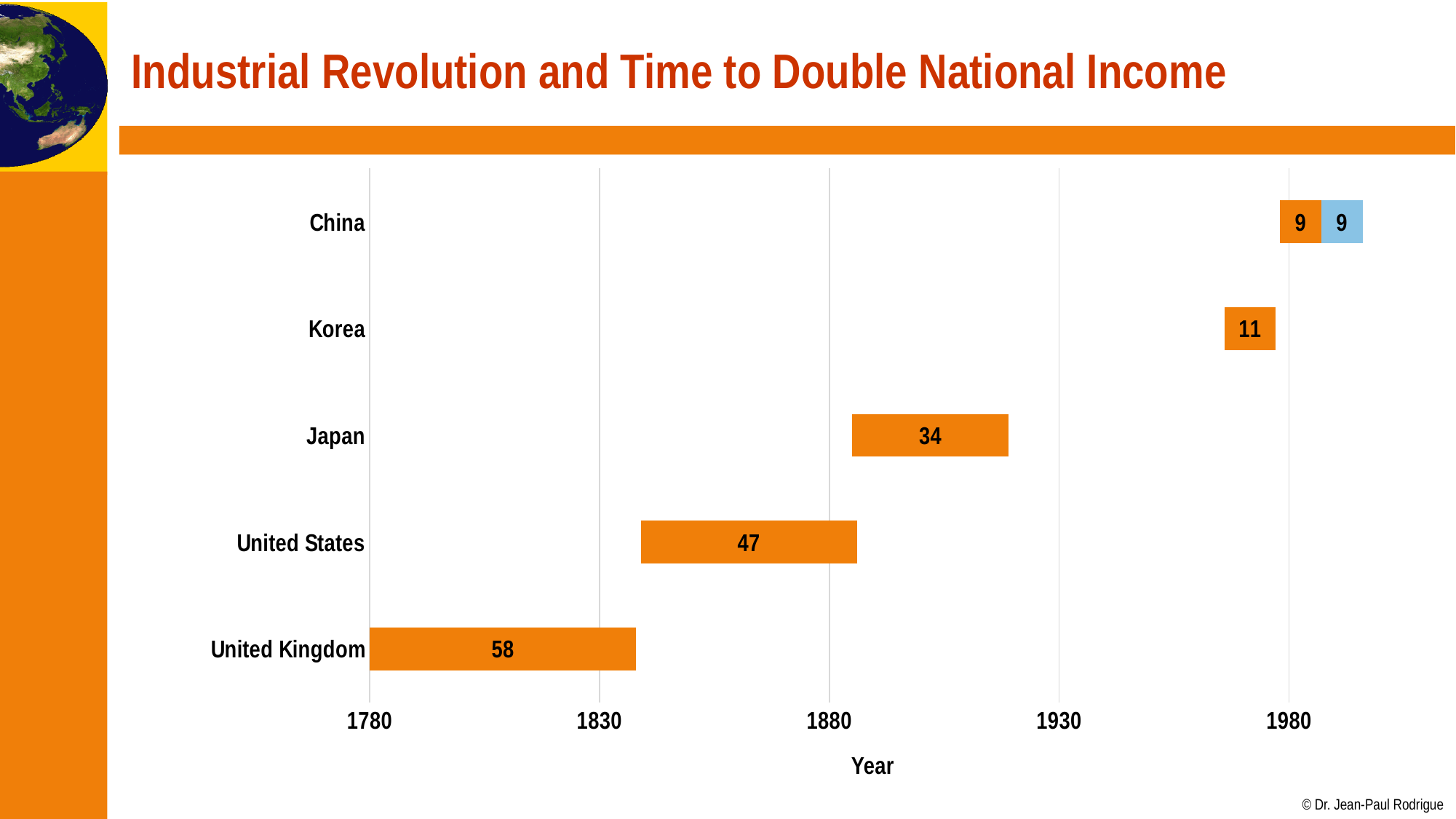
How many countries are shown on the chart? 5 Which country has the smallest labeled value? China Which is larger, the value for Japan or the value for Korea? Japan What kind of chart is shown on the slide? Bar chart What is the value labeled on the bar for Japan? 34 What is the value labeled on the bar for the United States? 47 What is the difference between the values for the United Kingdom and the United States? 11 Which country has the largest labeled value? United Kingdom What is the value labeled on the bar for Korea? 11 What is the value labeled on the bar for the United Kingdom? 58 What is the total of the two labeled segments of the China bar? 18 What is the title of the horizontal axis? Year